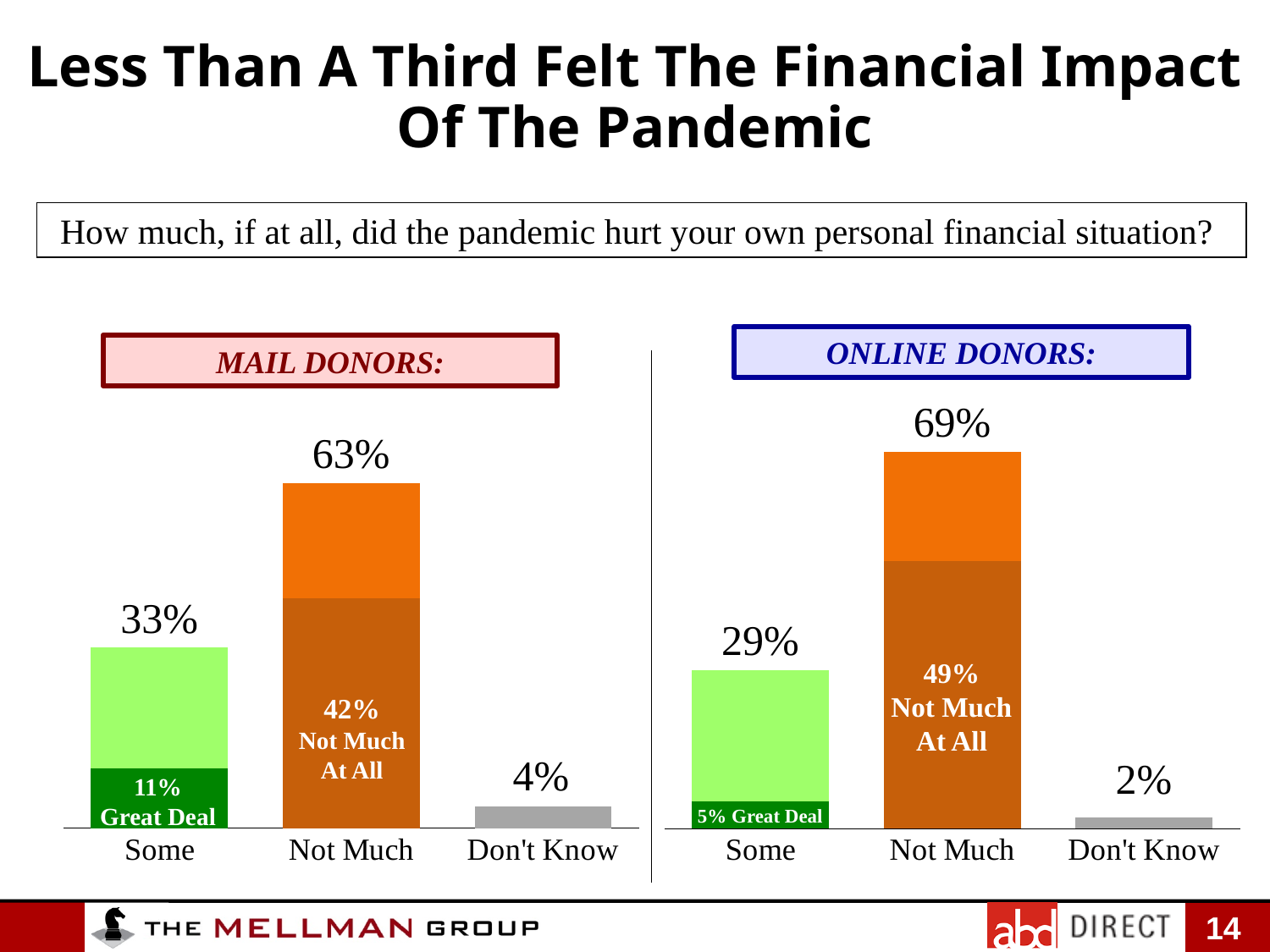
How many categories are shown on the x axis of the Mail Donors chart? 3 What kind of chart is used for the Online Donors data? Stacked bar chart In the Online Donors chart, what share said Not Much At All? 49% What is the difference between the Not Much totals for Online Donors and Mail Donors? 6 percentage points In the Mail Donors chart, what is the total value for Not Much? 63% In the Mail Donors chart, which category has the highest value? Not Much In the Mail Donors chart, what share said Great Deal? 11% In the Online Donors chart, what is the total value for Some? 29% In the Online Donors chart, which category has the lowest value? Don't Know In the Mail Donors chart, what is the difference between the Some total and the Great Deal portion? 22 percentage points In the Online Donors chart, what is the value for Don't Know? 2% Which is larger: the Some total for Mail Donors or the Some total for Online Donors? Mail Donors